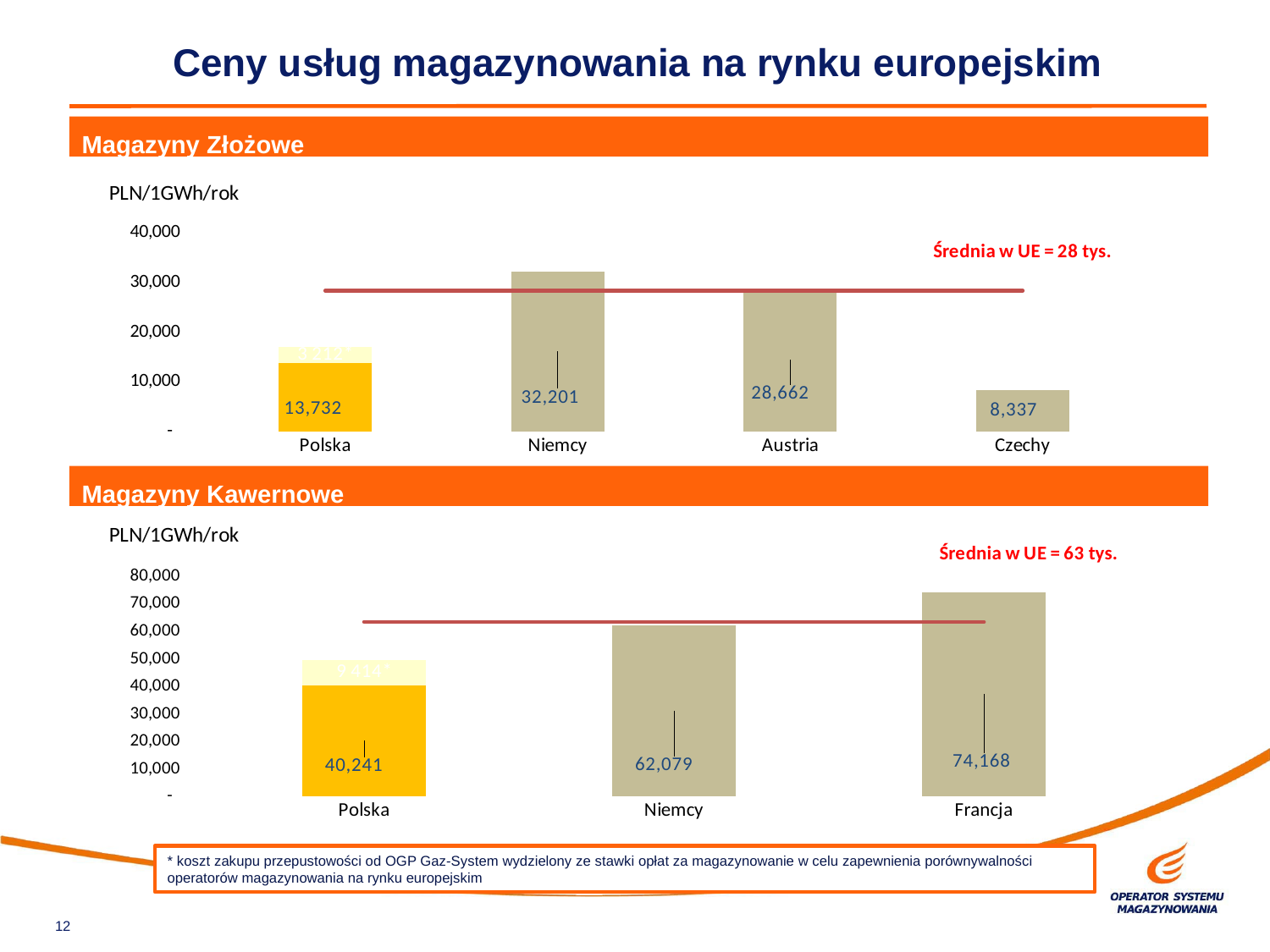
In the Magazyny Złożowe chart, what is the difference between the labelled values for Niemcy and Austria? 3,539 In the Magazyny Złożowe chart, how many countries are shown on the x axis? 4 In the Magazyny Złożowe chart, what is the value labelled for Czechy? 8,337 In the Magazyny Kawernowe chart, what is the value labelled for Niemcy? 62,079 In the Magazyny Kawernowe chart, which is larger, the value for Niemcy or the value for Francja? Francja In the Magazyny Kawernowe chart, what is the value labelled for Francja? 74,168 In the Magazyny Kawernowe chart, what is the difference between the labelled values for Francja and Niemcy? 12,089 In the Magazyny Złożowe chart, which country has the highest value? Niemcy In the Magazyny Kawernowe chart, is the value for Francja greater or less than 70,000? greater In the Magazyny Złożowe chart, what is the value labelled for Niemcy? 32,201 In the Magazyny Złożowe chart, which country has the lowest value? Czechy What kind of chart is the Magazyny Kawernowe chart? bar chart